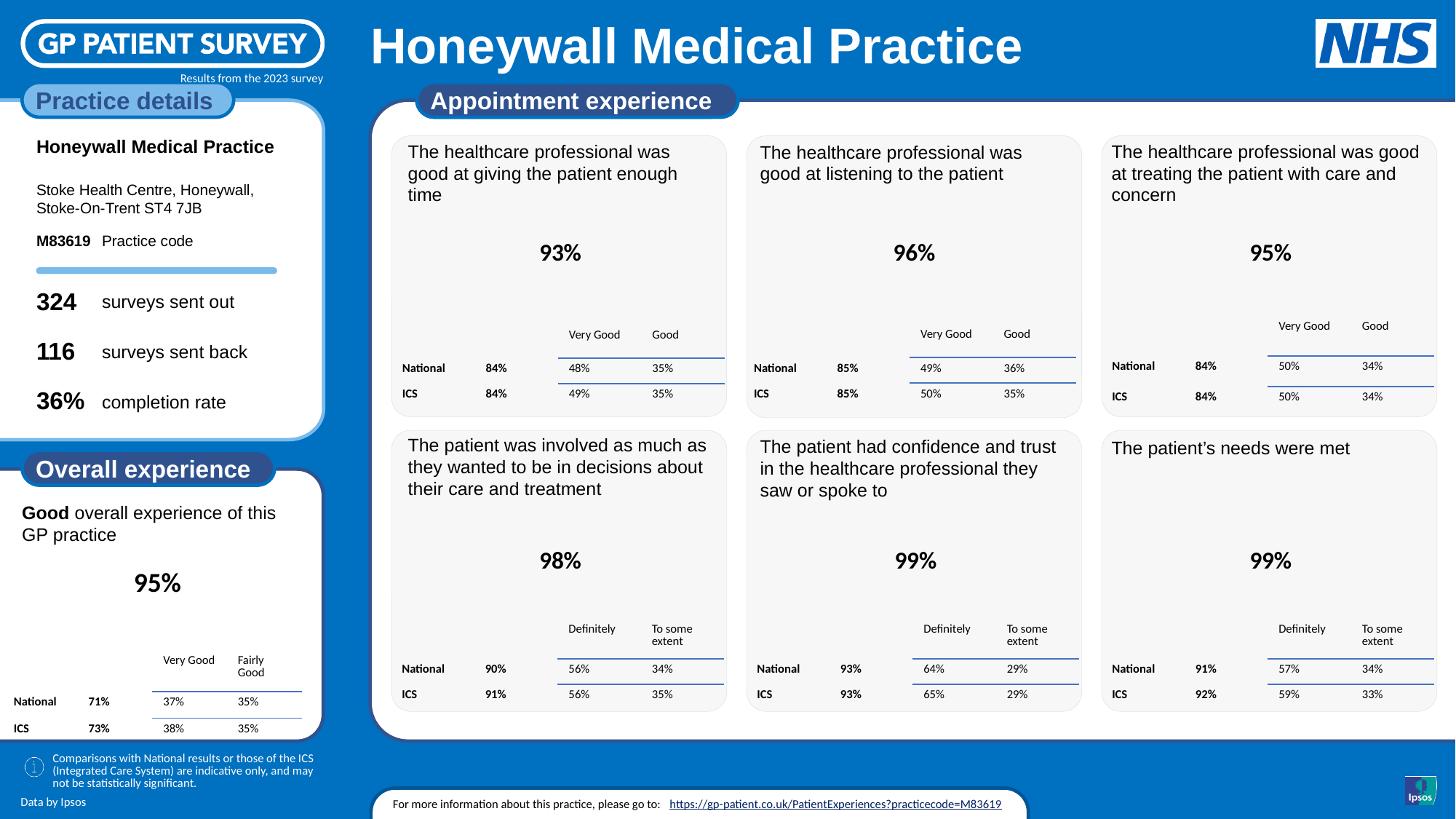
In the 'Appointment experience' section, which question has the lowest practice percentage? The healthcare professional was good at giving the patient enough time In the 'Overall experience' panel, what percentage of patients reported a good overall experience of this GP practice? 95% In the 'Overall experience' panel, what is the ICS 'Very Good' percentage? 38% In the 'Overall experience' panel, what is the National figure for good overall experience? 71% In the panel 'The patient had confidence and trust in the healthcare professional they saw or spoke to', which is larger: the National 'Definitely' percentage or the ICS 'Definitely' percentage? ICS (65%) In the 'Overall experience' panel, what is the difference between the practice's 95% and the National 71%? 24 percentage points In the 'Appointment experience' section, what is the practice's percentage for 'The patient's needs were met'? 99% In the panel 'The patient was involved as much as they wanted to be in decisions about their care and treatment', what is the ICS overall percentage? 91% In the 'Appointment experience' section, what percentage is shown for 'The healthcare professional was good at listening to the patient'? 96% In the panel 'The healthcare professional was good at treating the patient with care and concern', what is the difference between the practice's 95% and the ICS 84%? 11 percentage points In the panel 'The healthcare professional was good at giving the patient enough time', what is the National 'Very Good' percentage? 48% How many question panels are shown in the 'Appointment experience' section? 6